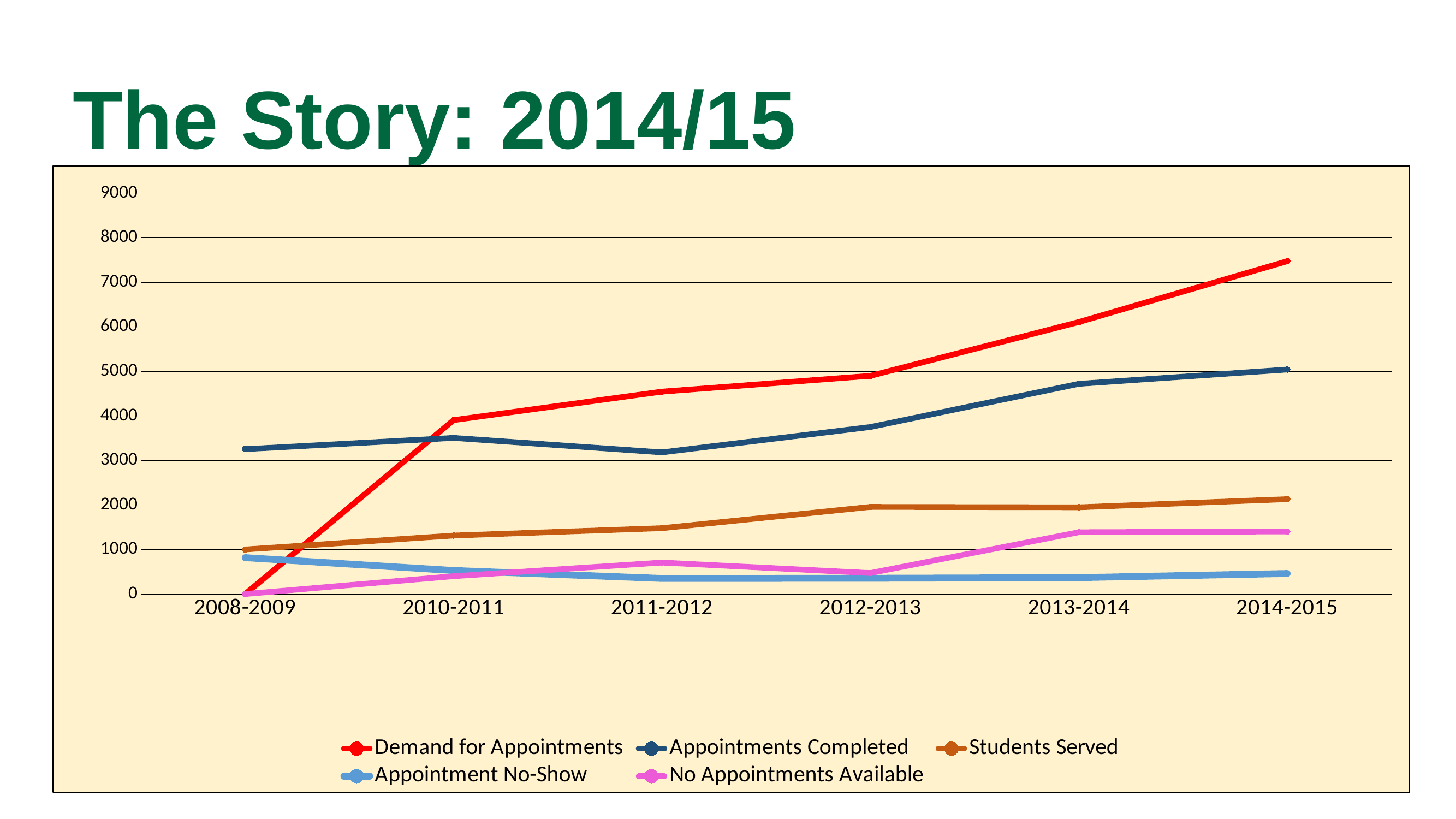
Is the value for Demand for Appointments in 2014-2015 greater or less than 7000? greater How many academic-year categories are shown on the x axis? 6 Does the Demand for Appointments line rise or fall from 2008-2009 to 2014-2015? rise Which series has the highest value in 2014-2015? Demand for Appointments Is the value for Appointment No-Show in 2014-2015 greater or less than 1000? less Is the value for No Appointments Available in 2013-2014 greater or less than 1000? greater What kind of chart is shown on the slide? line chart In 2008-2009, which is larger: Appointments Completed or Demand for Appointments? Appointments Completed Which series has the lowest value in 2014-2015? Appointment No-Show What colour is the Demand for Appointments line? red How many series does the legend list? 5